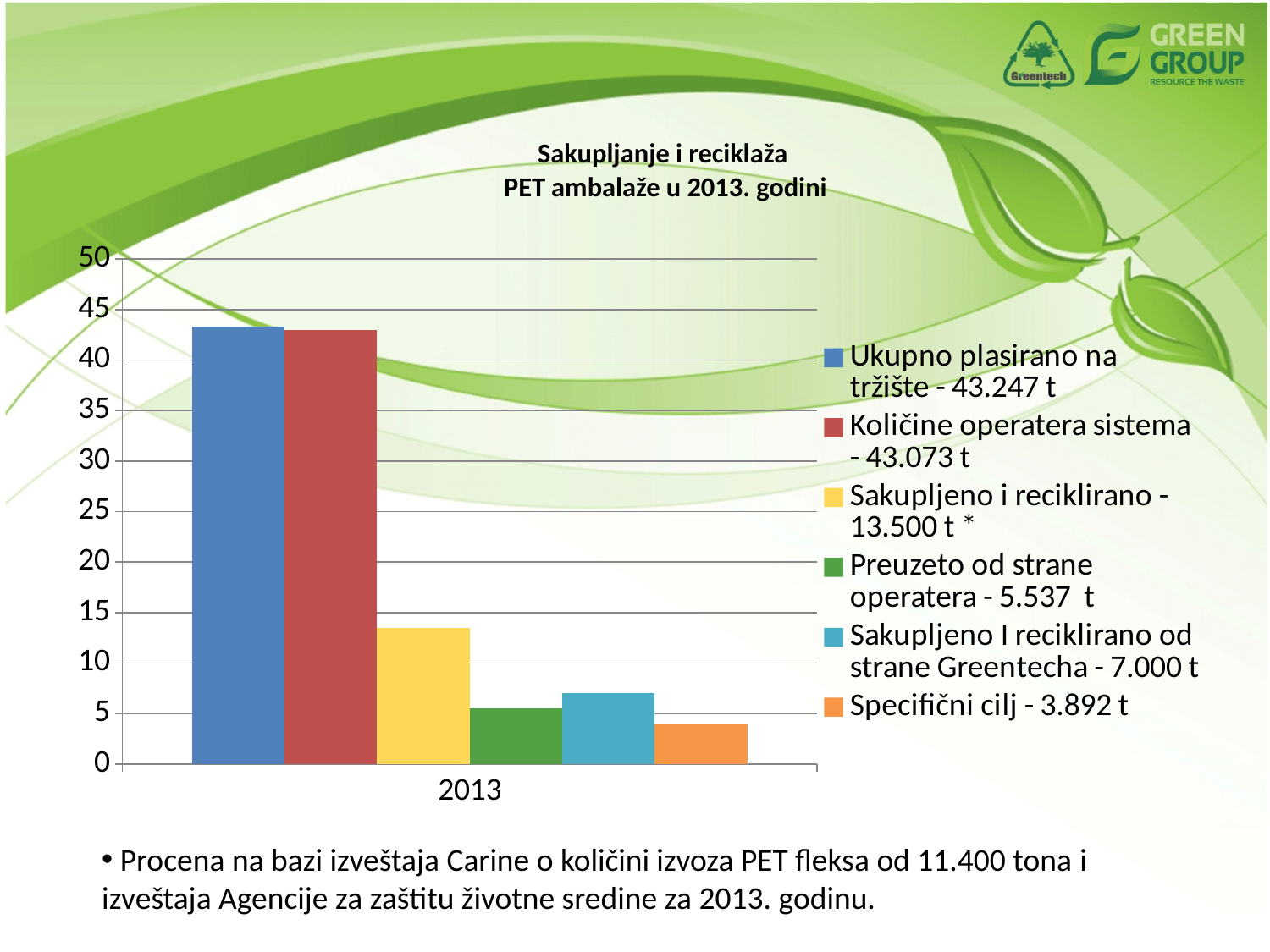
What value does the legend give for 'Ukupno plasirano na tržište'? 43.247 t What colour is the bar for 'Specifični cilj'? orange What is the title of the chart? Sakupljanje i reciklaža PET ambalaže u 2013. godini How many categories are shown on the x axis of the chart? 1 How many series does the chart legend list? 6 Is the bar for 'Sakupljeno i reciklirano' greater or less than 10 on the axis? greater What value does the legend give for 'Specifični cilj'? 3.892 t What is the difference between 'Sakupljeno i reciklirano' (13.500 t) and 'Sakupljeno I reciklirano od strane Greentecha' (7.000 t)? 6.500 t What type of chart is shown on the slide? bar chart What value does the legend give for 'Sakupljeno i reciklirano'? 13.500 t Which series has the lowest value in the chart? Specifični cilj Which is larger: 'Preuzeto od strane operatera' or 'Sakupljeno I reciklirano od strane Greentecha'? Sakupljeno I reciklirano od strane Greentecha